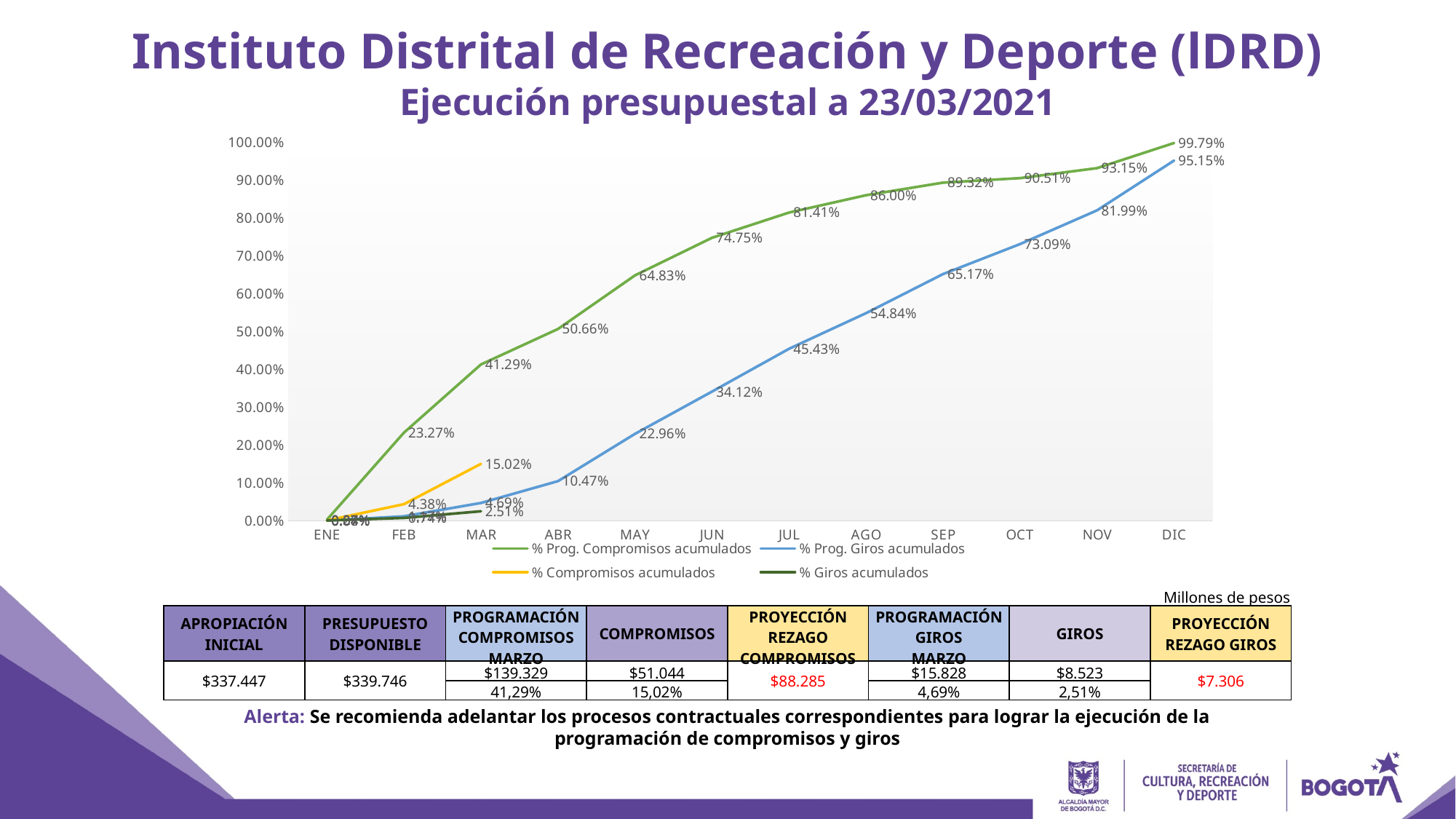
What is the value of % Prog. Compromisos acumulados in DIC? 99.79% What is the value of % Compromisos acumulados in MAR? 15.02% What is the value of % Prog. Giros acumulados in DIC? 95.15% What is the value of % Prog. Compromisos acumulados in JUN? 74.75% What type of chart is shown on the slide? line chart How many series does the chart legend list? 4 Does % Prog. Giros acumulados rise or fall from ENE to DIC? rise Which series is drawn in yellow in the chart? % Compromisos acumulados What is the value of % Prog. Giros acumulados in AGO? 54.84% How many months are shown along the x axis of the chart? 12 What is the difference between % Prog. Compromisos acumulados and % Prog. Giros acumulados in DIC? 4.64% Which is larger in MAR: % Prog. Compromisos acumulados or % Compromisos acumulados? % Prog. Compromisos acumulados